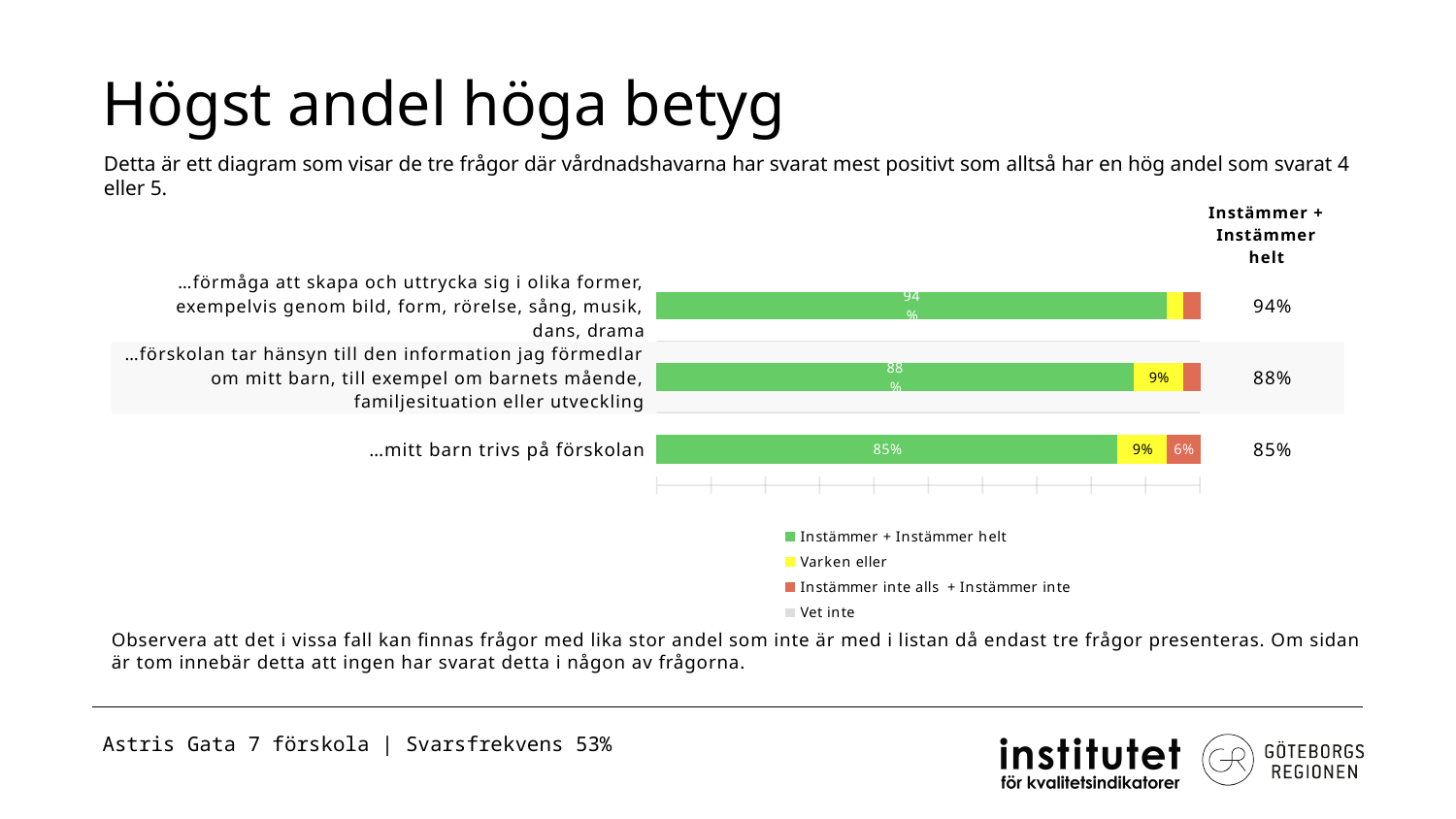
Which question has the lowest share of "Instämmer + Instämmer helt"? …mitt barn trivs på förskolan What is the share of "Instämmer inte alls + Instämmer inte" for "…mitt barn trivs på förskolan"? 6% What kind of chart is shown on the slide? bar chart What is the share of "Instämmer + Instämmer helt" for "…förmåga att skapa och uttrycka sig i olika former, exempelvis genom bild, form, rörelse, sång, musik, dans, drama"? 94% Which question has the highest share of "Instämmer + Instämmer helt"? …förmåga att skapa och uttrycka sig i olika former, exempelvis genom bild, form, rörelse, sång, musik, dans, drama What is the share of "Instämmer + Instämmer helt" for "…förskolan tar hänsyn till den information jag förmedlar om mitt barn, till exempel om barnets mående, familjesituation eller utveckling"? 88% What is the share of "Varken eller" for "…mitt barn trivs på förskolan"? 9% What is the share of "Instämmer + Instämmer helt" for "…mitt barn trivs på förskolan"? 85% How many questions (categories) are shown in the chart? 3 How many series does the legend list? 4 What is the difference in the "Instämmer + Instämmer helt" share between "…förmåga att skapa och uttrycka sig i olika former…" and "…mitt barn trivs på förskolan"? 9 percentage points Which colour represents "Varken eller" in the chart? yellow